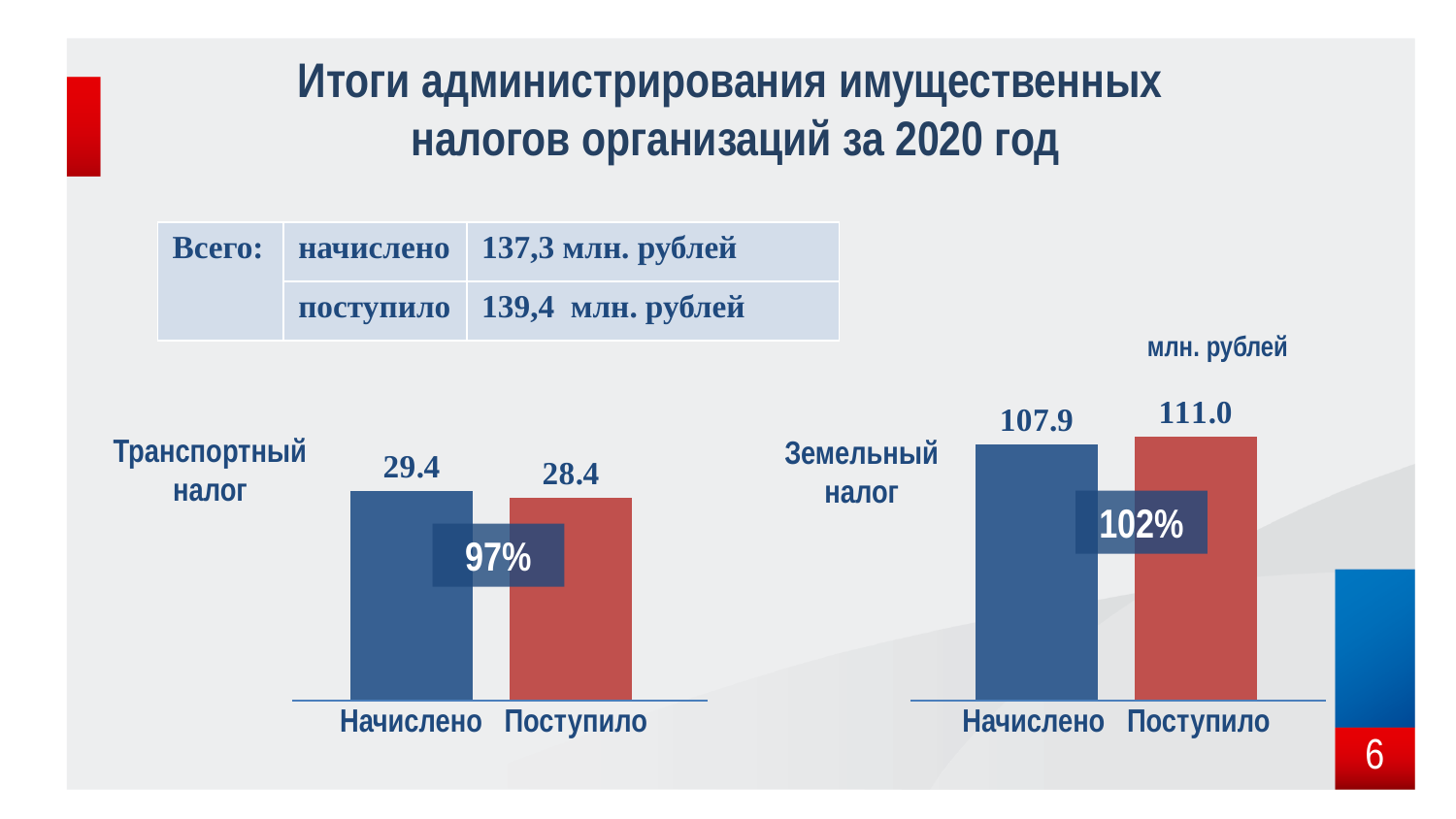
In the Транспортный налог chart, what is the value for Начислено? 29.4 What percentage label is shown between the bars of the Земельный налог chart? 102% What type of chart is used for Земельный налог? bar chart In the Транспортный налог chart, what is the value for Поступило? 28.4 In the Земельный налог chart, is Поступило larger or smaller than Начислено? larger In the Транспортный налог chart, which category has the higher value? Начислено How many bars are shown in the Транспортный налог chart? 2 In the Земельный налог chart, what is the value for Начислено? 107.9 In the Транспортный налог chart, what is the difference between Начислено and Поступило? 1.0 In the Земельный налог chart, what is the difference between Поступило and Начислено? 3.1 In the Земельный налог chart, what is the value for Поступило? 111.0 In the Земельный налог chart, which category has the lower value? Начислено